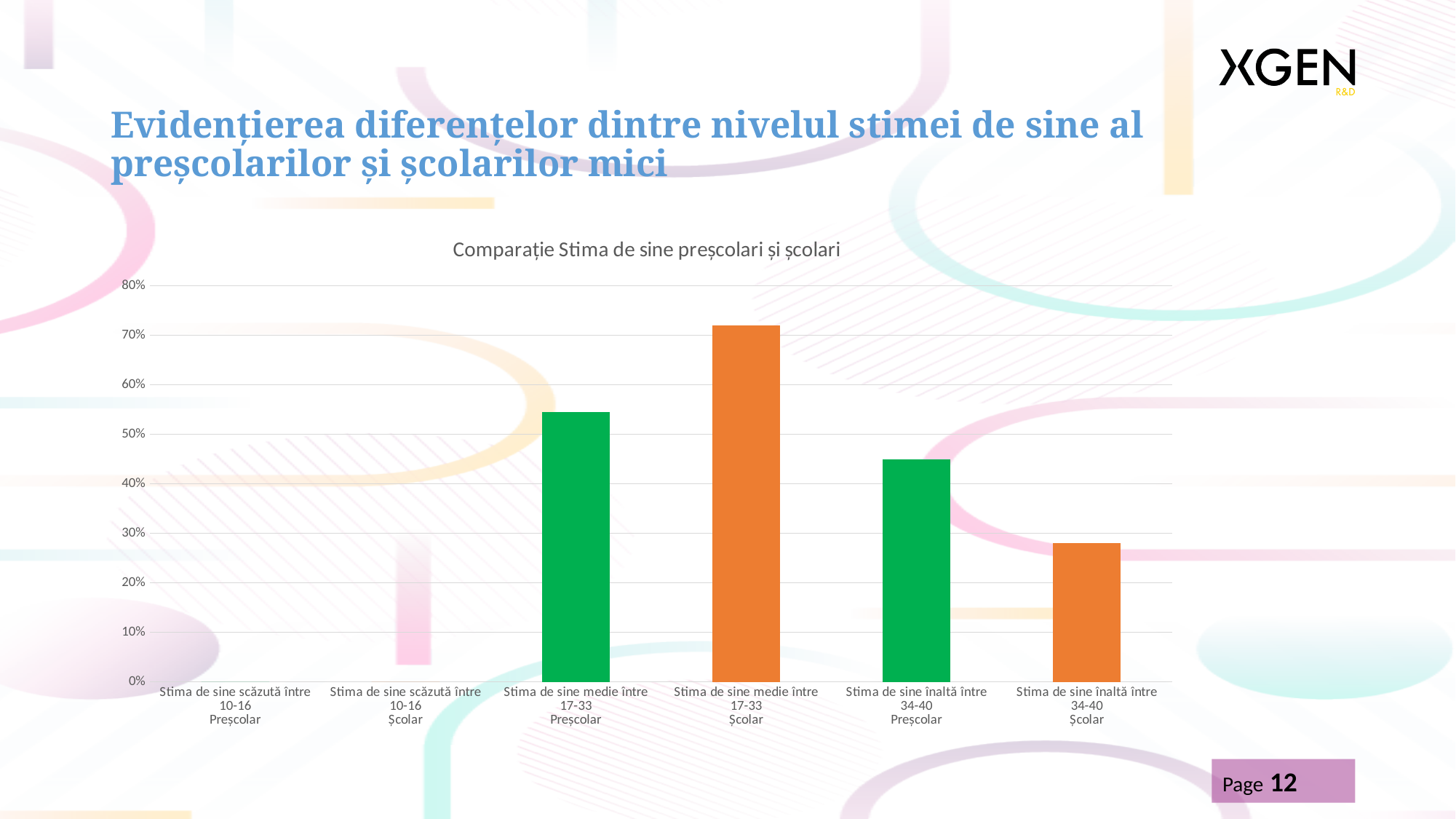
Which is larger: the value for 'Stima de sine înaltă între 34-40 Preșcolar' or 'Stima de sine înaltă între 34-40 Școlar'? Stima de sine înaltă între 34-40 Preșcolar What type of chart is shown on the slide? bar chart Is the value for 'Stima de sine medie între 17-33 Școlar' greater or less than 70%? greater What is the title of the chart? Comparație Stima de sine preșcolari și școlari Is the value for 'Stima de sine înaltă între 34-40 Școlar' greater or less than 30%? less Is the value for 'Stima de sine înaltă între 34-40 Preșcolar' greater or less than 50%? less Which is larger: the value for 'Stima de sine medie între 17-33 Școlar' or 'Stima de sine medie între 17-33 Preșcolar'? Stima de sine medie între 17-33 Școlar How many categories are shown on the x axis of the chart? 6 What colour are the bars for the Școlar categories? orange Which category has the highest bar in the chart? Stima de sine medie între 17-33 Școlar What is the value shown for 'Stima de sine scăzută între 10-16 Preșcolar'? 0%